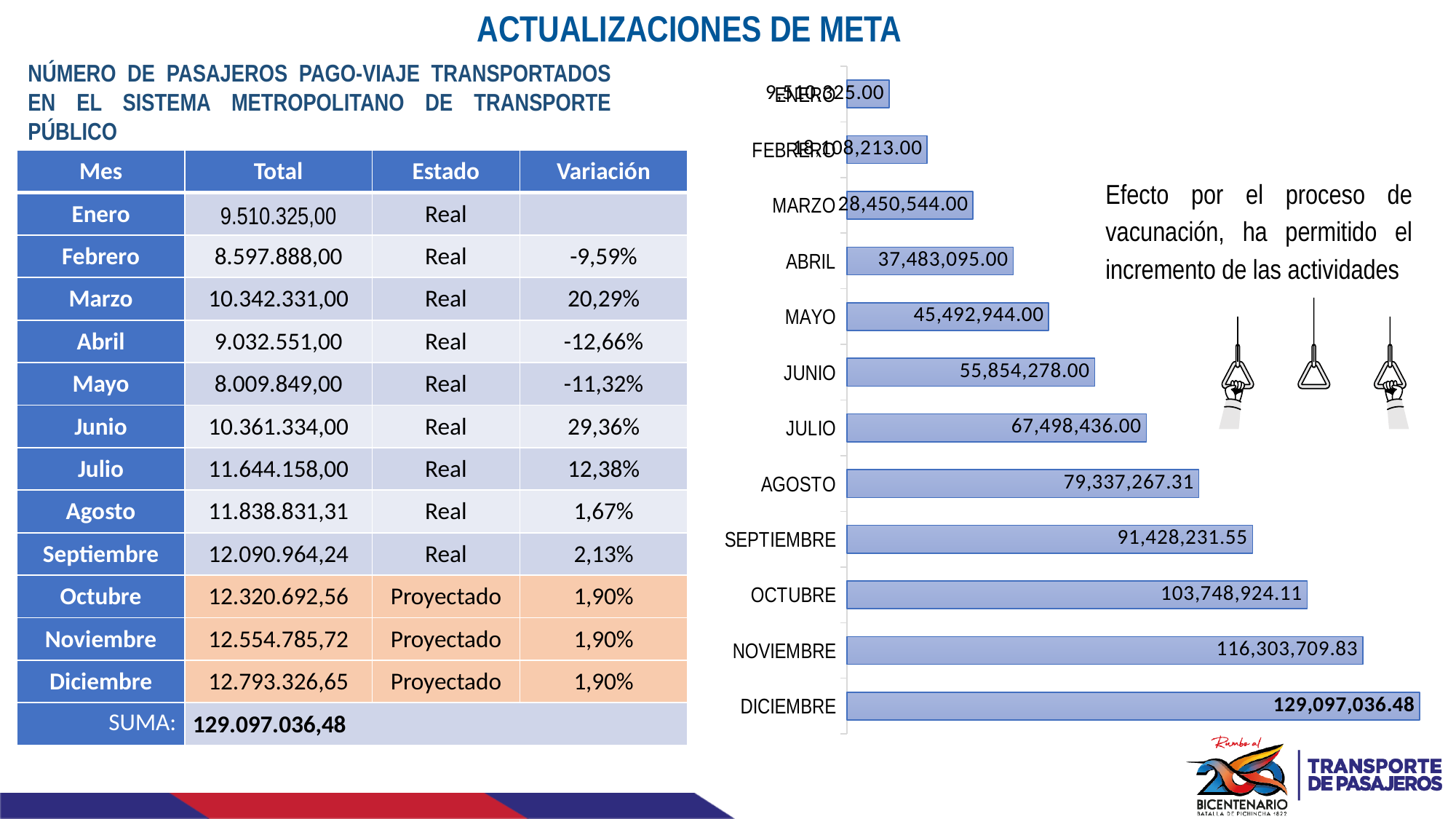
How many months are shown in the bar chart? 12 In the bar chart, which month has the lowest value? ENERO In the bar chart, what is the value for DICIEMBRE? 129,097,036.48 What kind of chart is shown on the right side of the slide? Bar chart In the bar chart, what is the value for AGOSTO? 79,337,267.31 In the bar chart, which is larger, the value for JULIO or the value for MAYO? JULIO In the bar chart, what is the difference between the values for OCTUBRE and SEPTIEMBRE? 12,320,692.56 In the bar chart, what is the value for JUNIO? 55,854,278.00 In the bar chart, which month has the highest value? DICIEMBRE In the bar chart, what is the value for MARZO? 28,450,544.00 In the bar chart, what is the value for OCTUBRE? 103,748,924.11 In the bar chart, what is the difference between the values for DICIEMBRE and NOVIEMBRE? 12,793,326.65